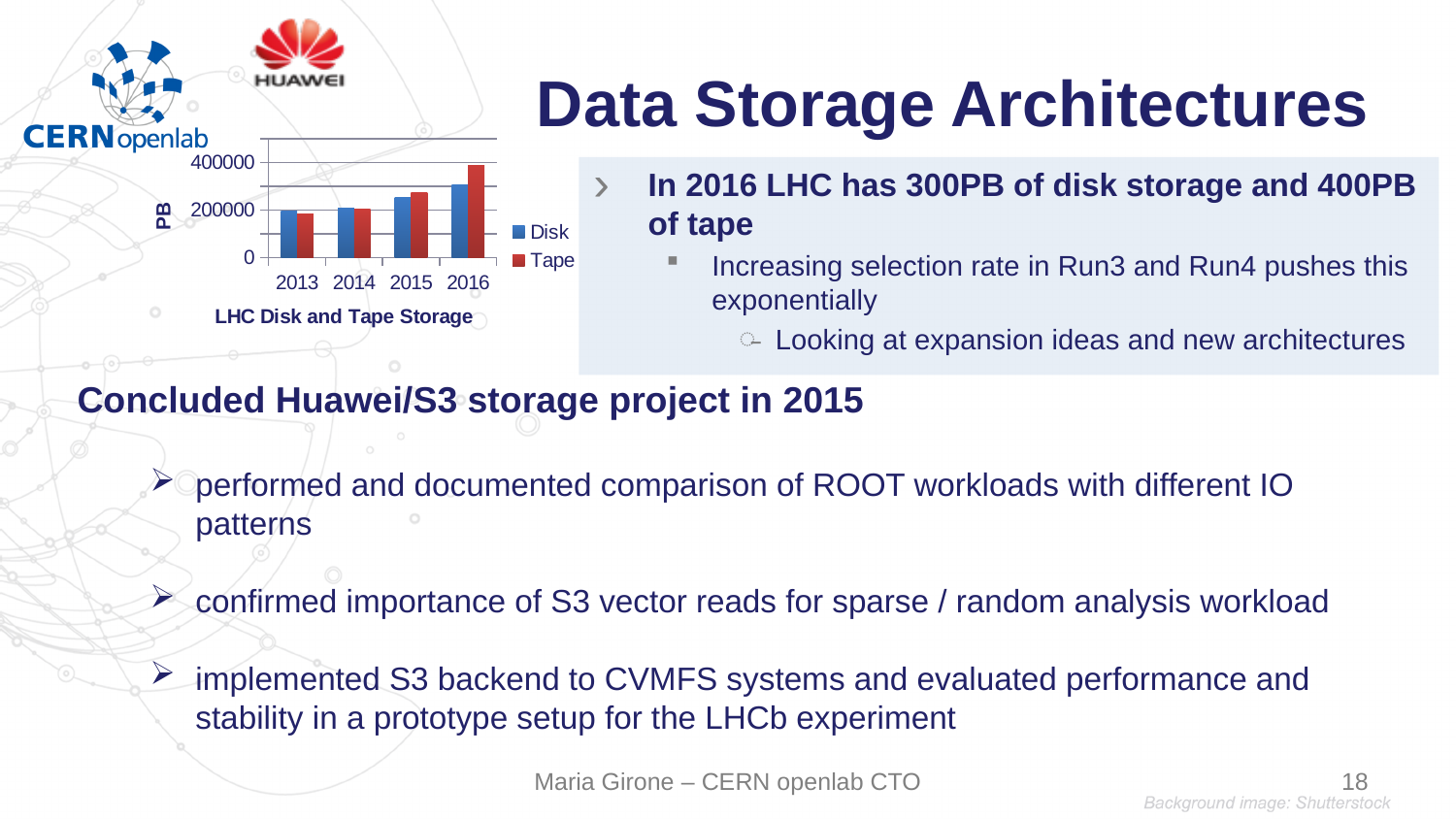
In which year is the Disk value highest? 2016 In 2016, which is larger, Disk or Tape? Tape How many years are shown along the x axis of the chart? 4 How many series does the chart's legend list? 2 Is the Tape value for 2016 greater or less than 200000? greater What kind of chart is shown on the slide? bar chart What is the title of the chart? LHC Disk and Tape Storage In which year is the Tape value highest? 2016 Is the Tape value for 2015 greater or less than 200000? greater Is the Disk value for 2016 greater or less than 200000? greater Do the Disk values rise or fall from 2013 to 2016? rise What is the label on the y axis of the chart? PB